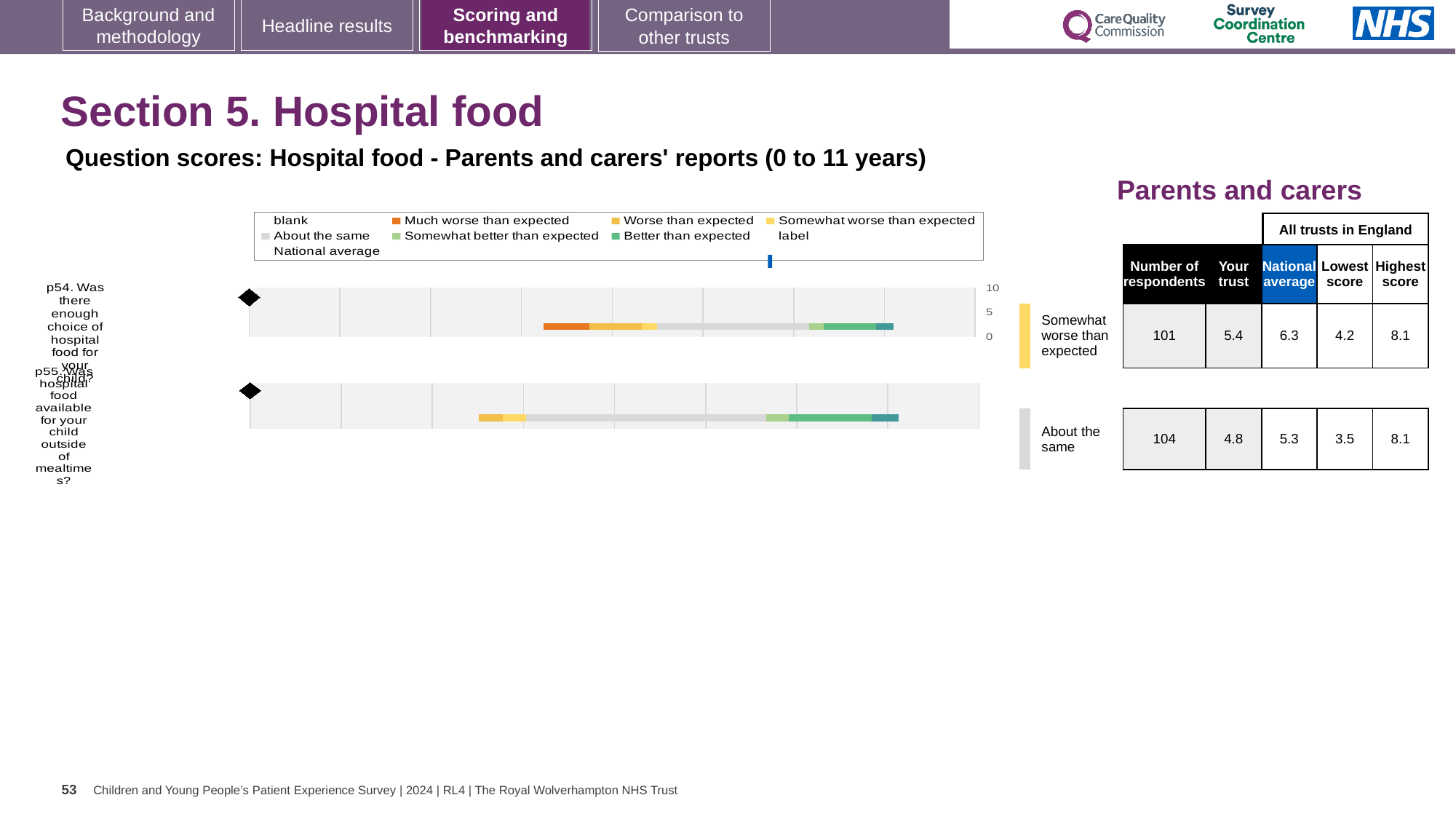
In the table beside the chart, which is larger for the 'Somewhat worse than expected' row: the 'Your trust' score or the national average? National average In the table beside the chart, what is the number of respondents for the row labelled 'About the same'? 104 In the table beside the chart, what is the difference between the highest score and the lowest score for the 'About the same' row? 4.6 In the table beside the chart, what is the national average for the row labelled 'About the same'? 5.3 In the chart legend, what does the blue vertical marker represent? National average In the table beside the chart, what is the difference between the national average and the 'Your trust' score for the 'Somewhat worse than expected' row? 0.9 In the table beside the chart, what is the lowest score for the row labelled 'Somewhat worse than expected'? 4.2 How many survey questions are plotted as bars in the chart? 2 In the table beside the chart, what is the 'Your trust' score for the row labelled 'Somewhat worse than expected'? 5.4 What is the title above the chart? Question scores: Hospital food - Parents and carers' reports (0 to 11 years) What kind of chart is shown on the slide? bar chart In the table beside the chart, what is the highest score for the row labelled 'About the same'? 8.1